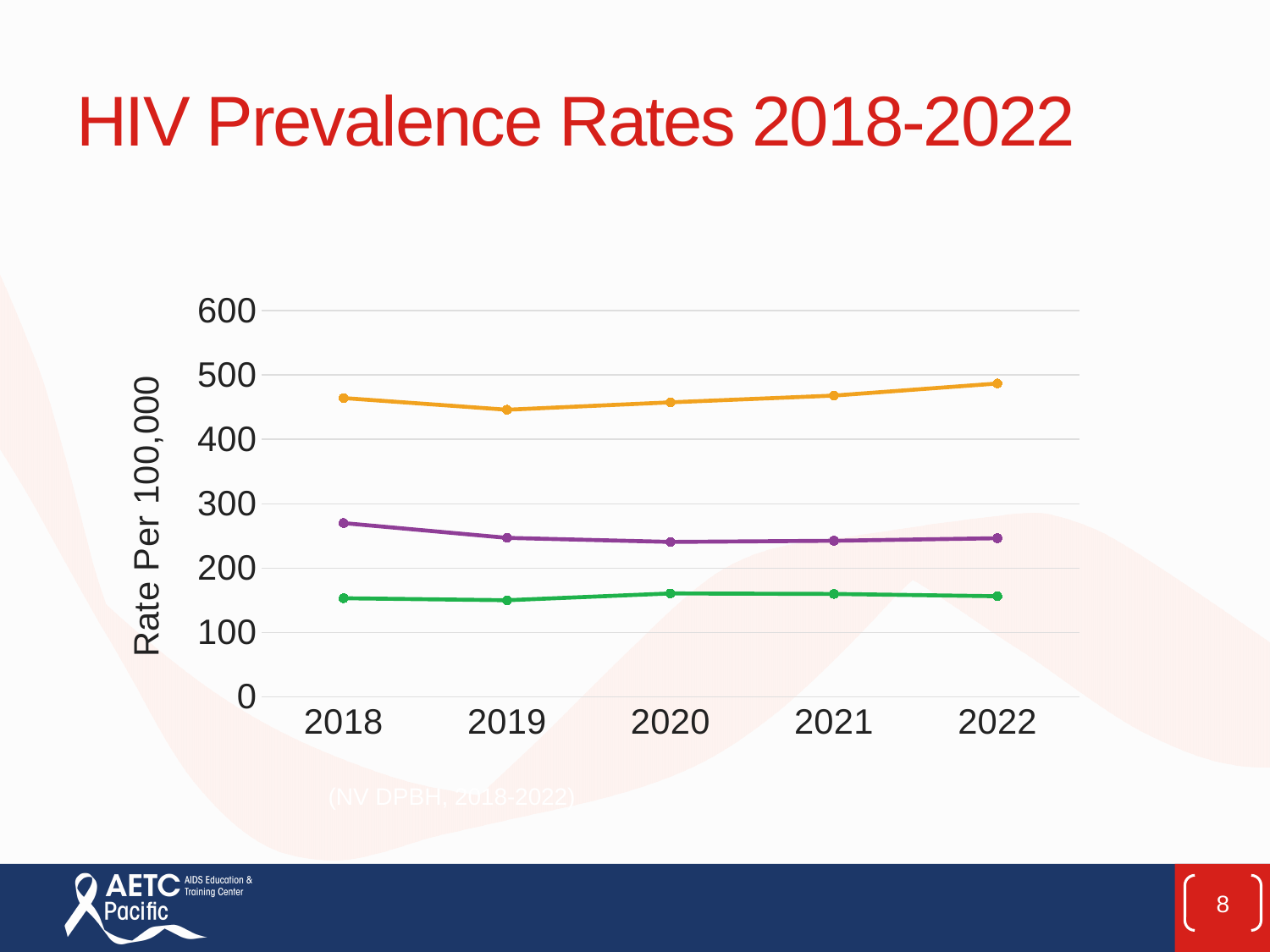
What is the label of the y axis? Rate Per 100,000 Which line has the larger value in 2020, the orange line or the purple line? orange In which year does the orange line reach its highest value? 2022 Is the value of the orange line in 2019 greater or less than 500? less What kind of chart is shown on the slide? line chart In which year does the purple line reach its highest value? 2018 Is the value of the purple line in 2018 greater or less than 300? less What is the title of the slide containing the chart? HIV Prevalence Rates 2018-2022 How many lines are plotted on the chart? 3 Is the value of the green line in 2020 greater or less than 200? less How many years are plotted along the x axis? 5